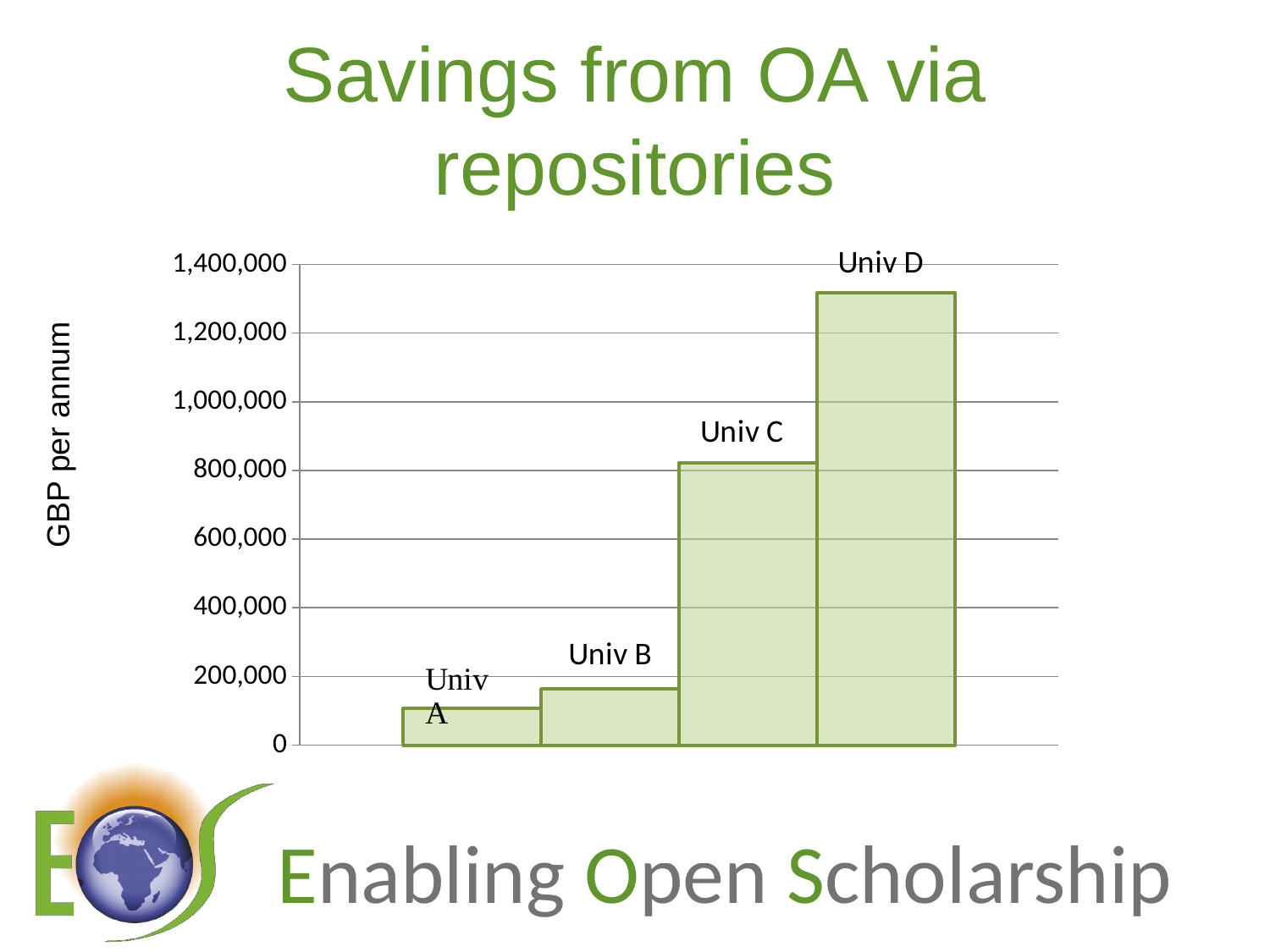
Which has larger savings, Univ D or Univ C? Univ D What is the label on the vertical axis of the chart? GBP per annum Is the value for Univ D greater or less than 1,200,000? greater Is the value for Univ C greater or less than 600,000? greater Do the values rise or fall from Univ A to Univ D? Rise Which university has the lowest savings in the chart? Univ A Which has larger savings, Univ C or Univ B? Univ C Is the value for Univ C greater or less than 1,000,000? less How many universities are shown in the chart? 4 What kind of chart is shown on the slide? Bar chart Which university has the highest savings in the chart? Univ D